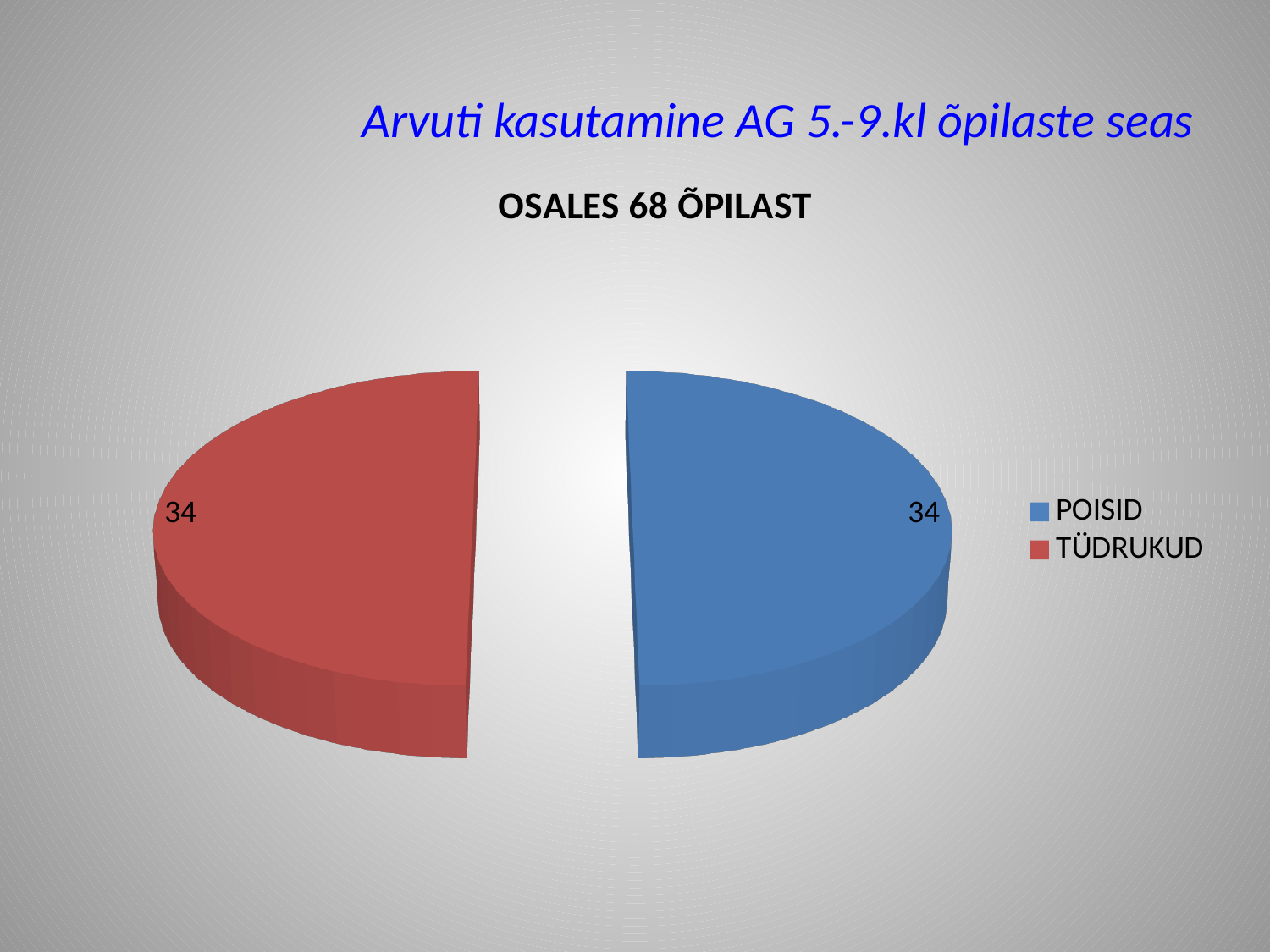
What is the total of the two slice values in the pie chart? 68 What value is shown for POISID? 34 What is the title of the chart? OSALES 68 ÕPILAST What share of the pie does the POISID slice represent? 50% What kind of chart is shown on the slide? pie chart What value is shown for TÜDRUKUD? 34 How many slices does the pie chart have? 2 What is the difference between the values for POISID and TÜDRUKUD? 0 Which colour represents TÜDRUKUD in the legend? red What share of the pie does the TÜDRUKUD slice represent? 50%